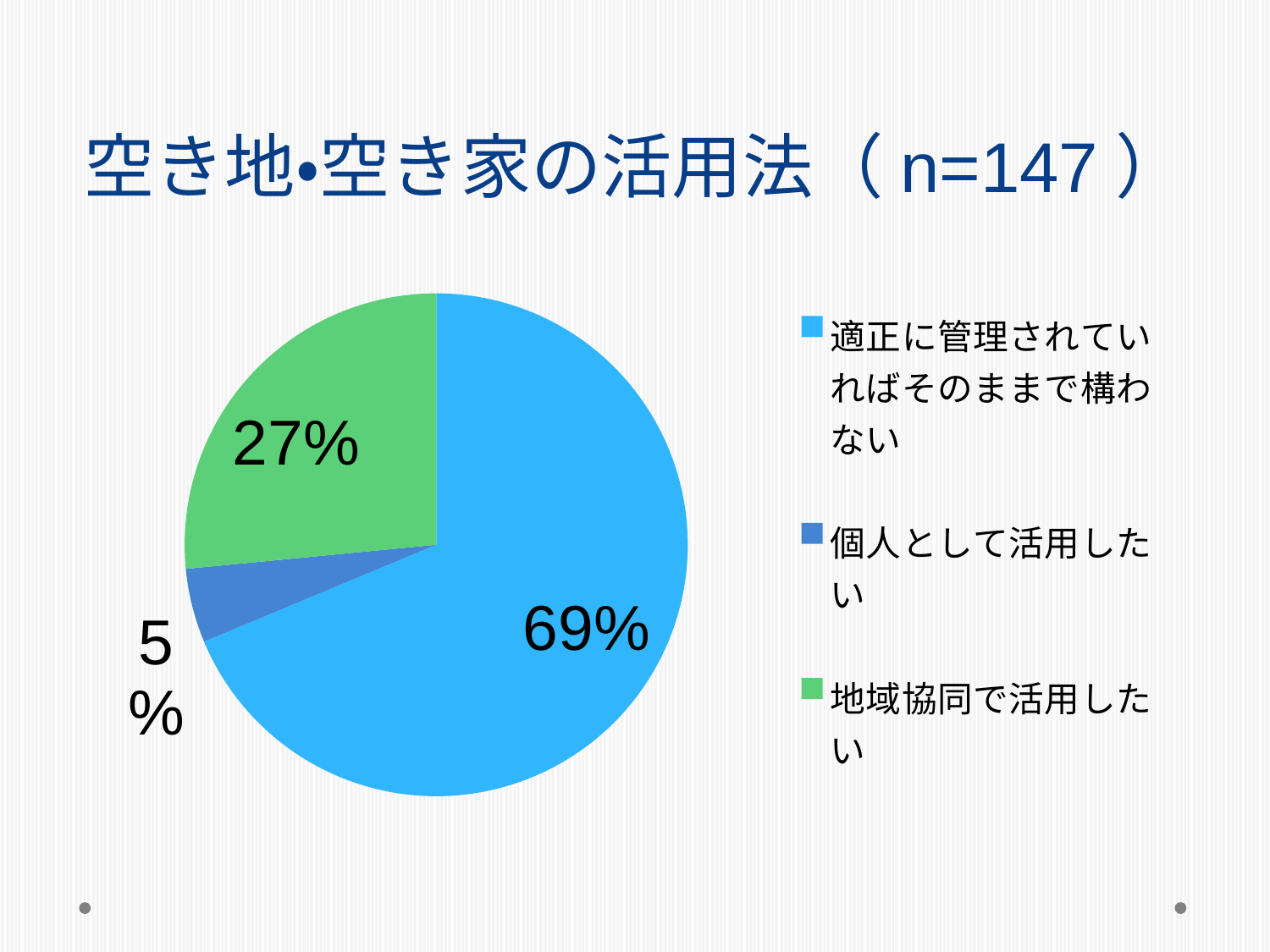
What share of the pie is labelled for 個人として活用したい? 5% What is the title of the chart on the slide? 空き地•空き家の活用法（n=147） What is the difference in percentage points between 適正に管理されていればそのままで構わない and 地域協同で活用したい? 42 What share of the pie is labelled for 適正に管理されていればそのままで構わない? 69% Which category has the smallest slice of the pie? 個人として活用したい How many slices does the pie chart have? 3 What kind of chart is shown on the slide? pie chart What colour is the slice for 地域協同で活用したい? green Which is larger: the slice for 地域協同で活用したい or the slice for 個人として活用したい? 地域協同で活用したい What share of the pie is labelled for 地域協同で活用したい? 27% What is the difference in percentage points between 地域協同で活用したい and 個人として活用したい? 22 Which category has the largest slice of the pie? 適正に管理されていればそのままで構わない